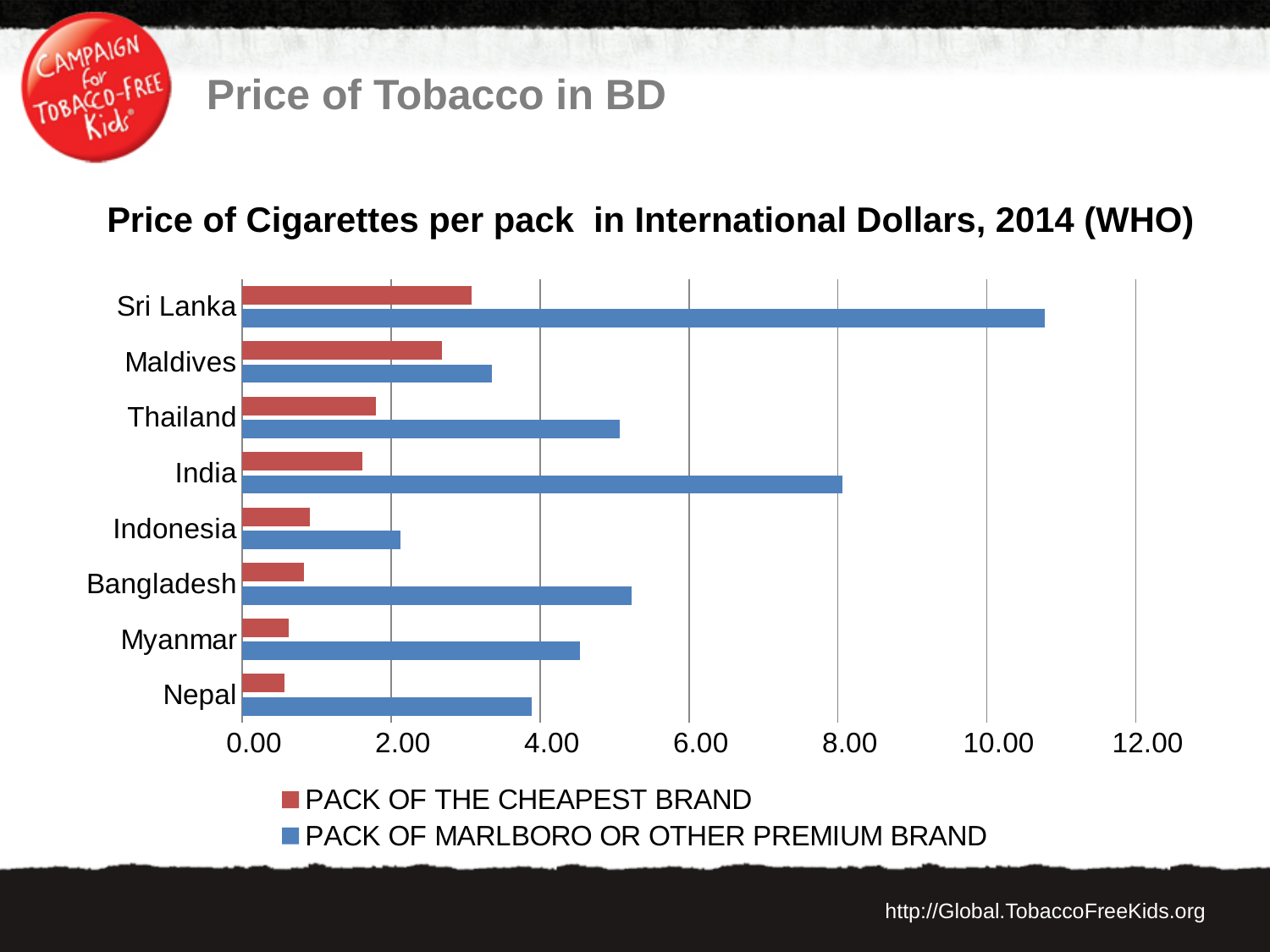
Is the price of a pack of Marlboro or other premium brand in Sri Lanka greater or less than 10.00? greater Is the price of a pack of the cheapest brand in Nepal greater or less than 2.00? less How many series does the legend list? 2 How many countries are listed on the chart? 8 Is the price of a pack of Marlboro or other premium brand in Bangladesh greater or less than 4.00? greater Which colour represents the pack of the cheapest brand in the legend? Red What kind of chart is shown on the slide? Bar chart Which is higher, the premium brand price in India or the premium brand price in Thailand? India Which country has the lowest price for a pack of Marlboro or other premium brand? Indonesia Which country has the highest price for a pack of Marlboro or other premium brand? Sri Lanka Which country has the highest price for a pack of the cheapest brand? Sri Lanka